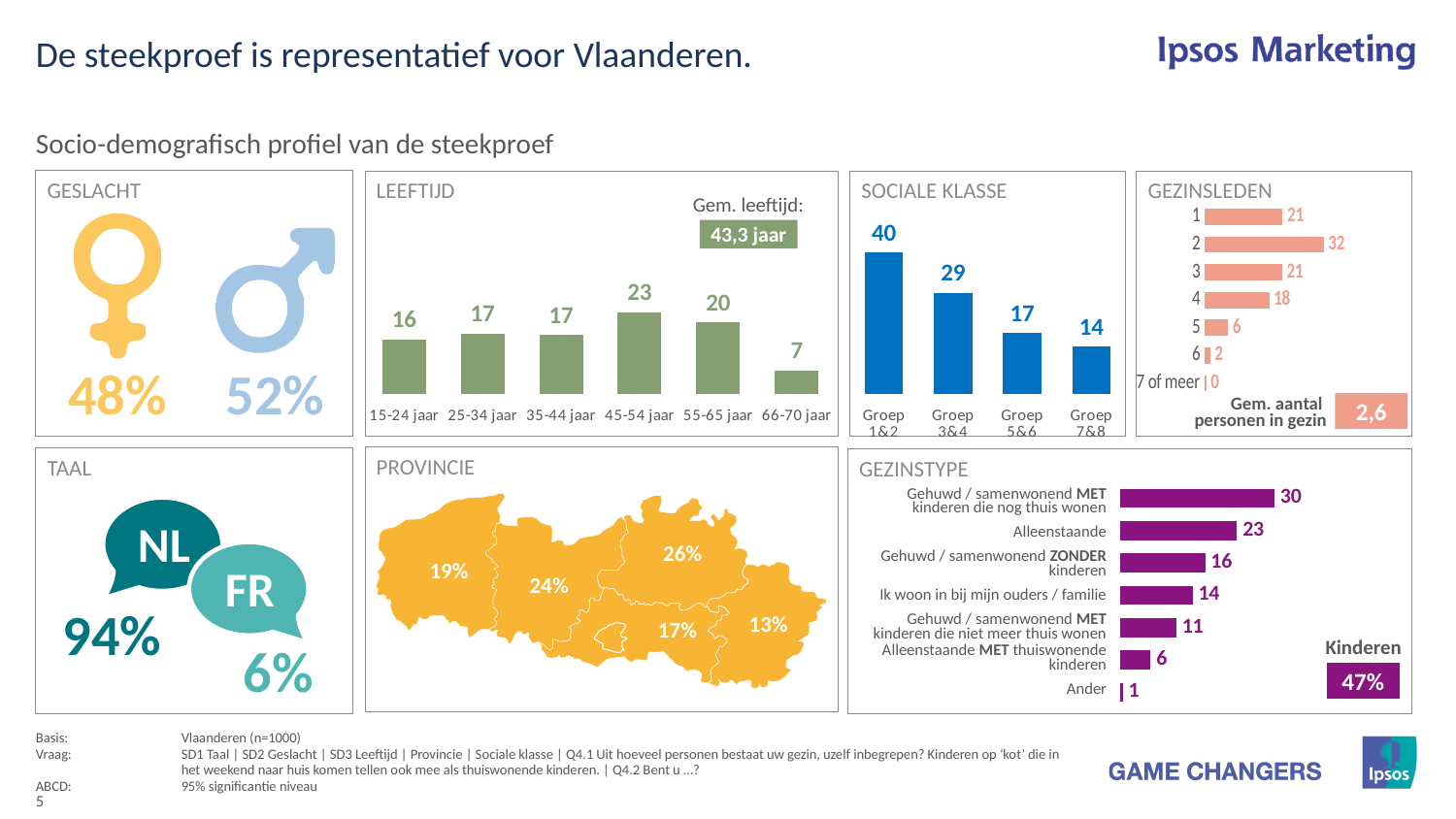
In the SOCIALE KLASSE chart, which group has the highest value? Groep 1&2 In the GEZINSTYPE chart, what is the value for Alleenstaande? 23 In the GEZINSTYPE chart, which is larger: 'Ik woon in bij mijn ouders / familie' or 'Gehuwd / samenwonend MET kinderen die niet meer thuis wonen'? Ik woon in bij mijn ouders / familie What type of chart is used in the SOCIALE KLASSE panel? Bar chart In the SOCIALE KLASSE chart, what is the value for Groep 3&4? 29 In the SOCIALE KLASSE chart, what is the difference between Groep 1&2 and Groep 7&8? 26 In the GEZINSLEDEN chart, which household size has the highest value? 2 In the GEZINSLEDEN chart, what is the value for households of 2 persons? 32 In the GEZINSTYPE chart, which category has the lowest value? Ander How many age categories are shown in the LEEFTIJD chart? 6 In the LEEFTIJD chart, which age category has the lowest value? 66-70 jaar In the LEEFTIJD chart, what is the value for the 45-54 jaar category? 23